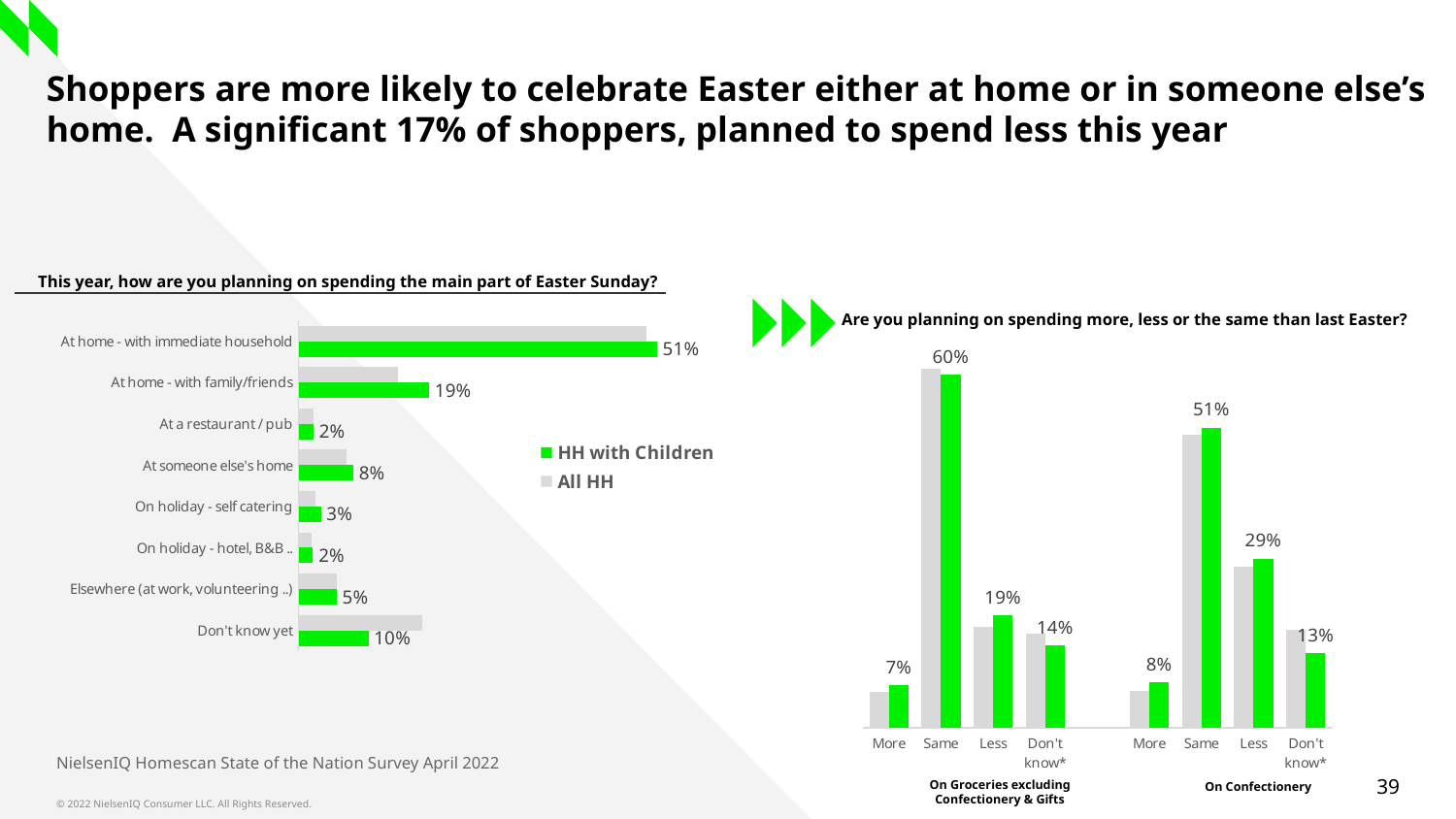
What type of chart is the left chart 'This year, how are you planning on spending the main part of Easter Sunday?'? Bar chart In the left chart, which series is shown in green according to the legend? HH with Children In the left chart 'This year, how are you planning on spending the main part of Easter Sunday?', how many categories are shown? 8 In the left chart 'This year, how are you planning on spending the main part of Easter Sunday?', which category has the highest labelled value? At home - with immediate household In the right chart 'Are you planning on spending more, less or the same than last Easter?', what is the labelled value for 'Same' on Groceries excluding Confectionery & Gifts? 60% In the right chart 'Are you planning on spending more, less or the same than last Easter?', what is the difference between the labelled values for 'Same' on Groceries excluding Confectionery & Gifts and 'Same' on Confectionery? 9% In the left chart 'This year, how are you planning on spending the main part of Easter Sunday?', what is the labelled value for 'Don't know yet'? 10% In the left chart 'This year, how are you planning on spending the main part of Easter Sunday?', what is the difference between the labelled values for 'At home - with immediate household' and 'At home - with family/friends'? 32% In the right chart 'Are you planning on spending more, less or the same than last Easter?', what is the labelled value for 'Less' on Confectionery? 29% In the right chart 'Are you planning on spending more, less or the same than last Easter?', which is larger: the labelled value for 'Less' on Groceries excluding Confectionery & Gifts or 'Less' on Confectionery? Less on Confectionery In the left chart 'This year, how are you planning on spending the main part of Easter Sunday?', how many series does the legend list? 2 In the left chart 'This year, how are you planning on spending the main part of Easter Sunday?', what is the labelled value for 'At home - with immediate household'? 51%